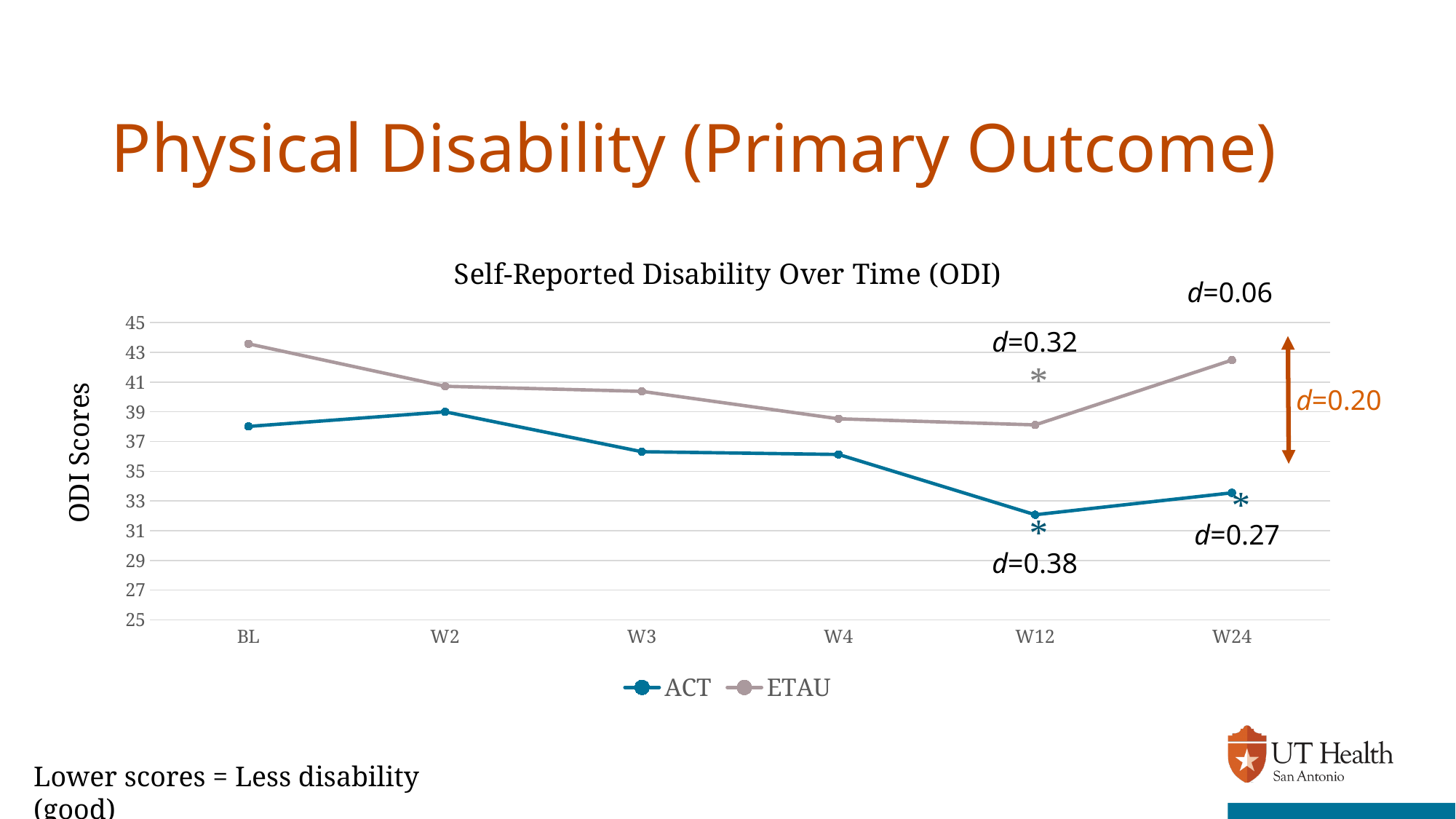
Is the ACT value at W3 greater or less than 35? greater What kind of chart is shown on the slide? line chart At which time point is the ACT series lowest? W12 Does the ACT series generally rise or fall from BL to W12? fall At which time point is the ACT series highest? W2 At which time point is the ETAU series highest? BL At W12, which series has the higher ODI score, ACT or ETAU? ETAU What is the title of the chart? Self-Reported Disability Over Time (ODI) Is the ETAU value at W24 greater or less than 41? greater How many series does the legend list? 2 Is the ACT value at W12 greater or less than 33? less How many time points are plotted along the x axis? 6